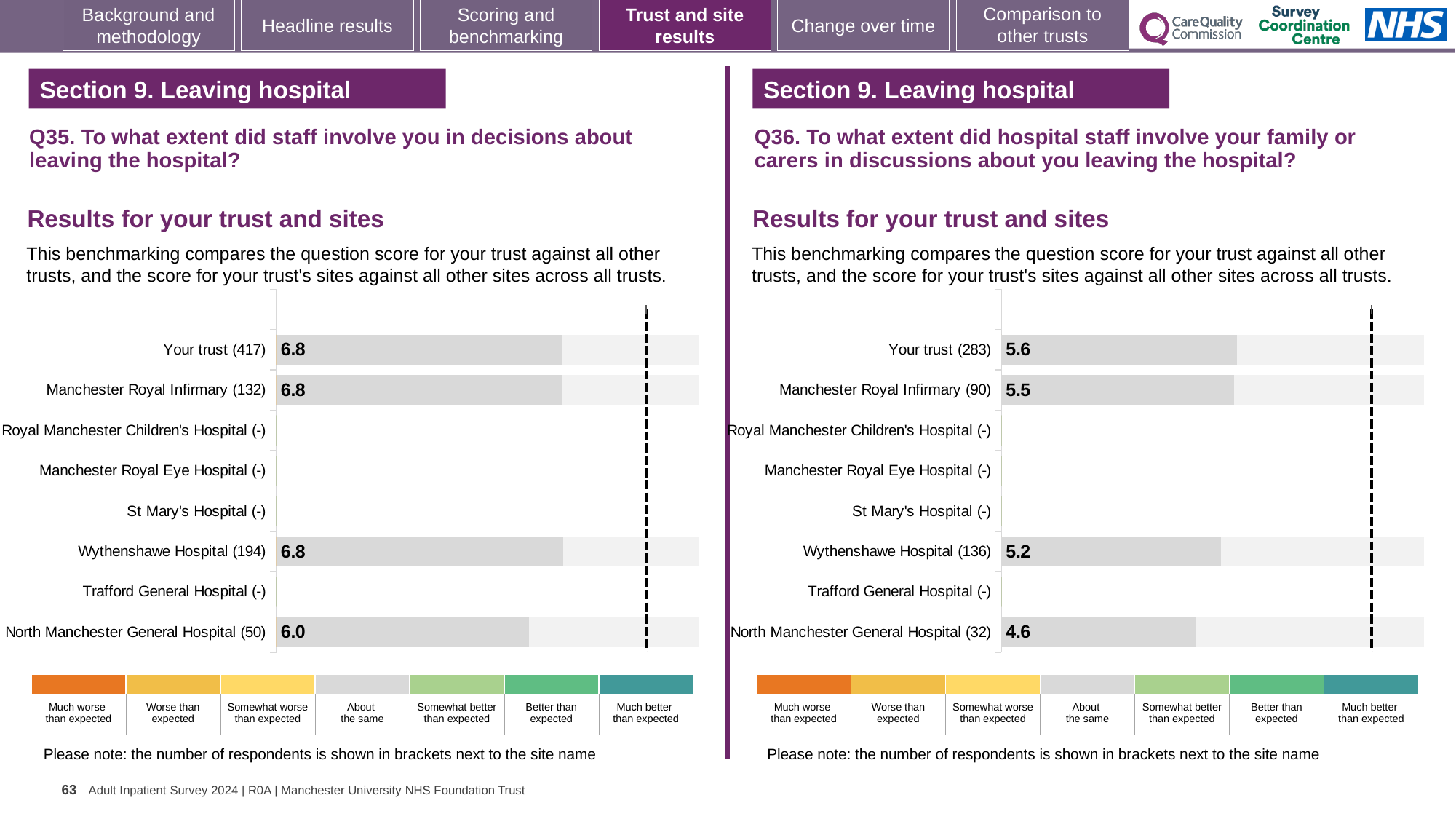
On the Q35 chart (left), what is the difference between the score for Your trust (417) and North Manchester General Hospital (50)? 0.8 On the Q35 chart (left), what is the score for North Manchester General Hospital (50)? 6.0 On the Q36 chart (right), how many sites have a plotted score bar? 3 On the Q36 chart (right), which site has the highest score among the sites with a plotted bar? Manchester Royal Infirmary (90) On the Q36 chart (right), what is the score for Wythenshawe Hospital (136)? 5.2 On the Q36 chart (right), what is the score for Your trust (283)? 5.6 How many site categories are listed on the Q35 chart (left)? 8 On the Q35 chart (left), what is the score for Your trust (417)? 6.8 On the Q36 chart (right), what is the difference between the score for Your trust (283) and North Manchester General Hospital (32)? 1.0 On the Q36 chart (right), which site has the lowest score? North Manchester General Hospital (32) On the Q36 chart (right), which is larger: the score for Manchester Royal Infirmary (90) or Wythenshawe Hospital (136)? Manchester Royal Infirmary (90) What type of chart is used on the Q35 chart (left)? Bar chart